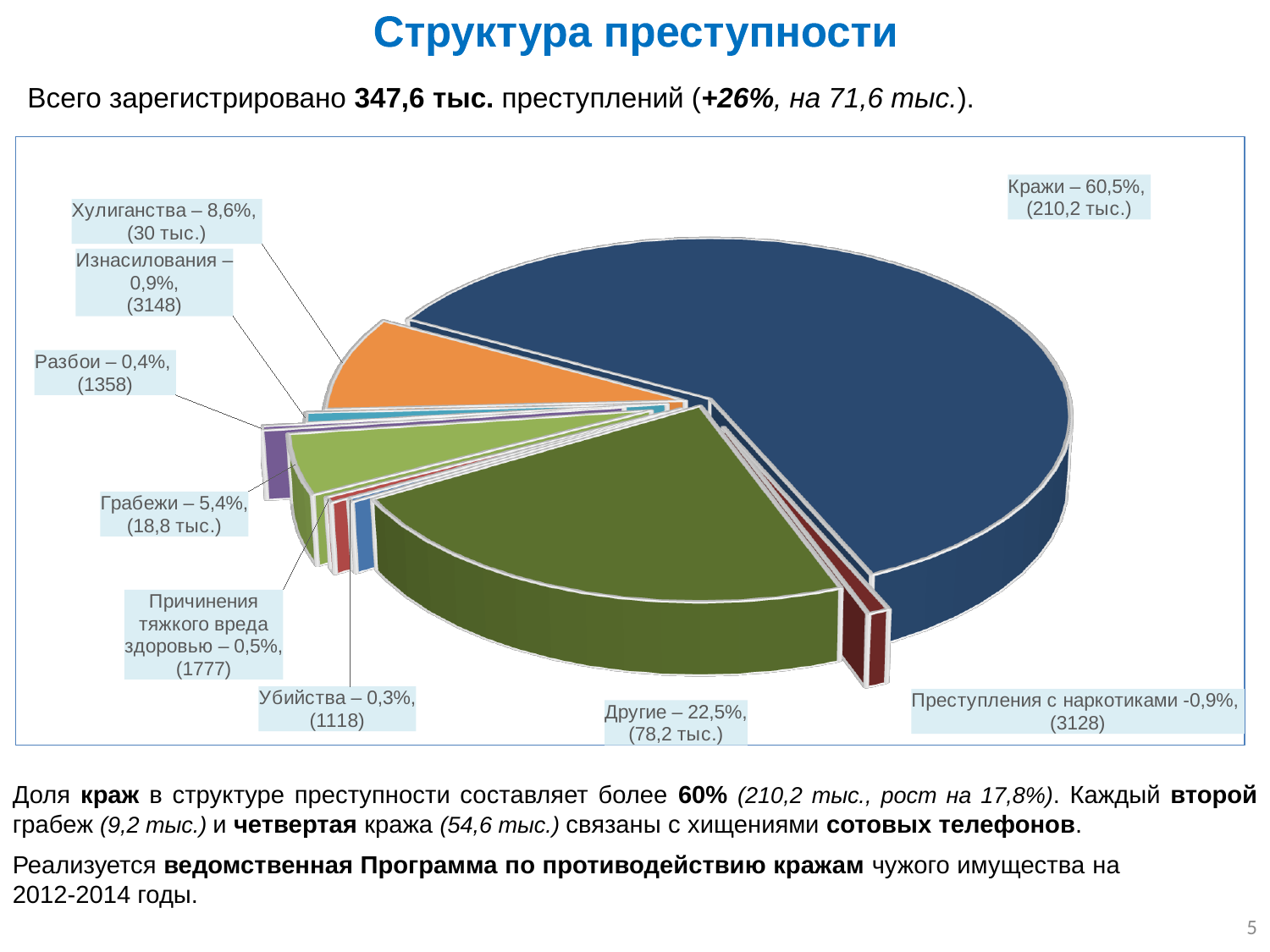
Which category has the largest slice of the pie? Кражи Which has a larger share, Хулиганства or Грабежи? Хулиганства What is the number shown for Преступления с наркотиками? 3128 Which category has the smallest share of the pie? Убийства What is the number shown for Убийства? 1118 How many slices does the pie chart have? 9 What is the title of the chart? Структура преступности What is the number of crimes shown for Грабежи? 18,8 тыс. What kind of chart is shown on the slide? pie chart What is the difference in percentage points between Кражи and Другие? 38 percentage points What share of the pie does Кражи account for? 60,5% What percentage is shown for Хулиганства? 8,6%